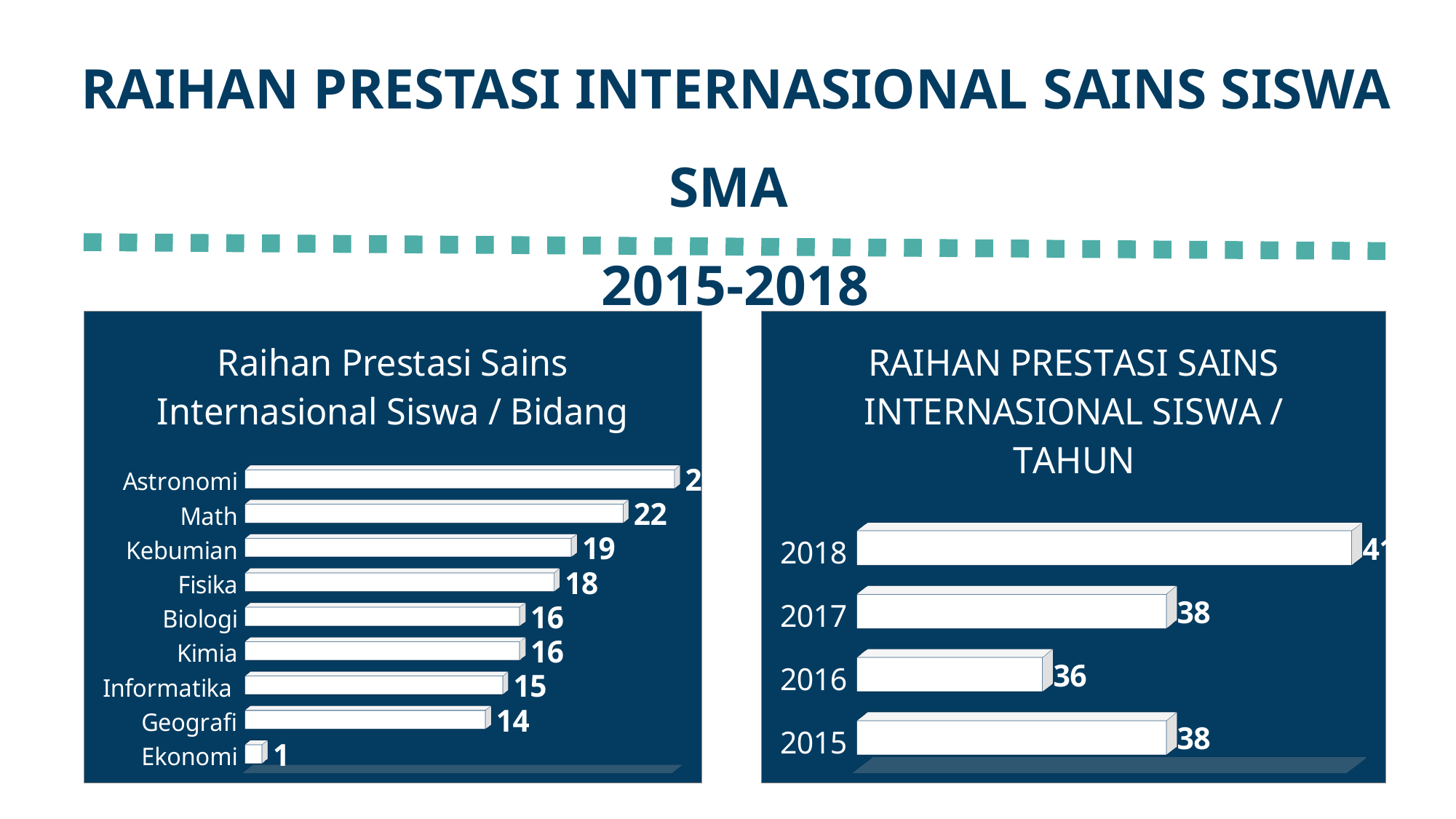
How many categories are shown in the left chart (Raihan Prestasi Sains Internasional Siswa / Bidang)? 9 In the left chart (Raihan Prestasi Sains Internasional Siswa / Bidang), which is larger, the value for Informatika or the value for Kebumian? Kebumian In the right chart (RAIHAN PRESTASI SAINS INTERNASIONAL SISWA / TAHUN), what is the value for 2016? 36 What kind of chart is the right chart (RAIHAN PRESTASI SAINS INTERNASIONAL SISWA / TAHUN)? bar chart In the left chart (Raihan Prestasi Sains Internasional Siswa / Bidang), what is the value for Kebumian? 19 In the right chart (RAIHAN PRESTASI SAINS INTERNASIONAL SISWA / TAHUN), what is the difference between the values for 2017 and 2016? 2 In the left chart (Raihan Prestasi Sains Internasional Siswa / Bidang), what is the difference between the values for Fisika and Geografi? 4 How many years are shown in the right chart (RAIHAN PRESTASI SAINS INTERNASIONAL SISWA / TAHUN)? 4 In the left chart (Raihan Prestasi Sains Internasional Siswa / Bidang), which category has the highest value? Astronomi In the left chart (Raihan Prestasi Sains Internasional Siswa / Bidang), what is the value for Math? 22 In the right chart (RAIHAN PRESTASI SAINS INTERNASIONAL SISWA / TAHUN), which year has the highest value? 2018 In the left chart (Raihan Prestasi Sains Internasional Siswa / Bidang), which category has the lowest value? Ekonomi